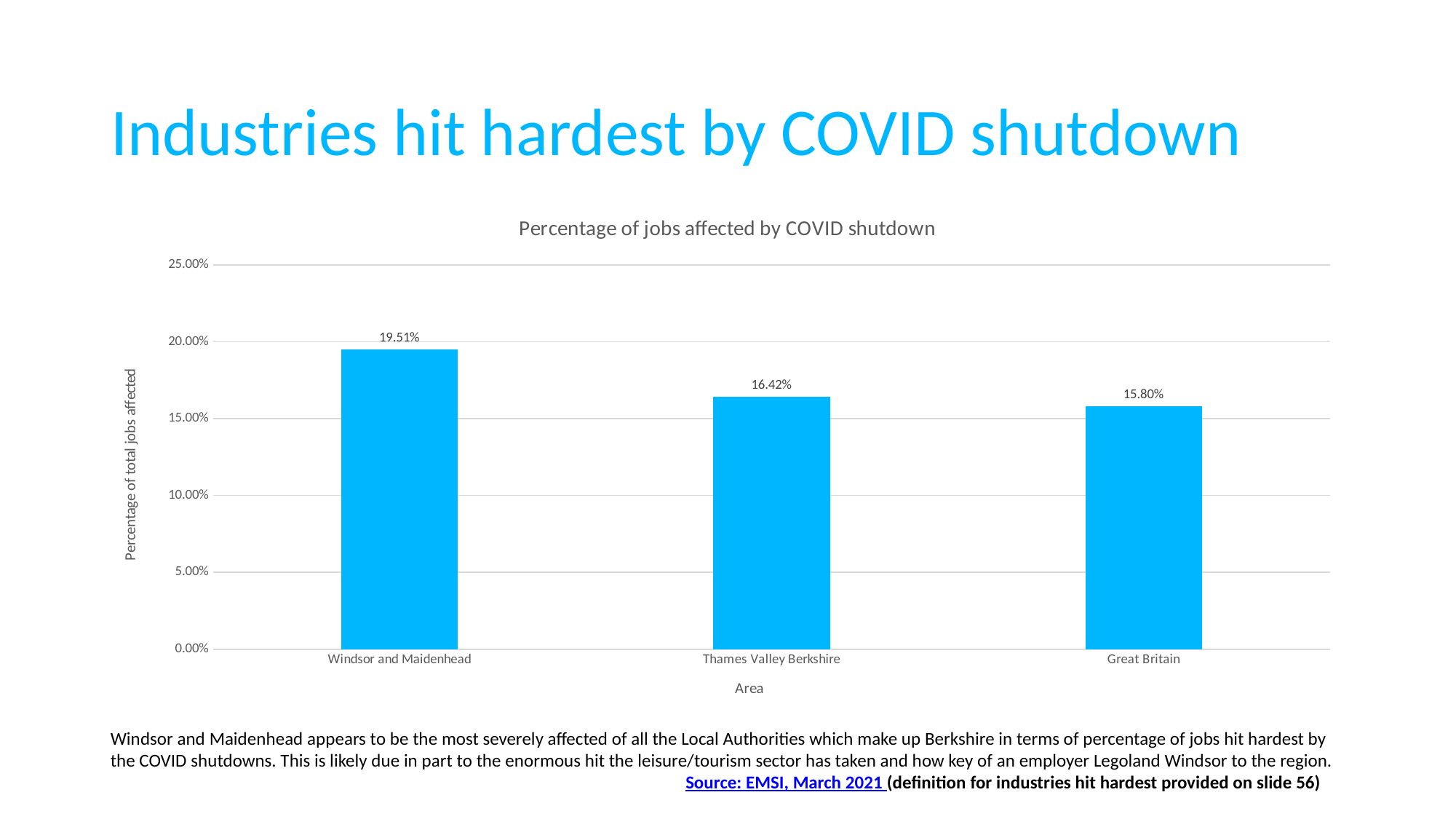
Which area has the highest percentage of jobs affected by COVID shutdown? Windsor and Maidenhead What is the difference in percentage points between Windsor and Maidenhead and Great Britain? 3.71% What kind of chart is shown on the slide? Bar chart Which has a higher percentage of jobs affected: Thames Valley Berkshire or Great Britain? Thames Valley Berkshire What is the percentage of jobs affected by COVID shutdown for Thames Valley Berkshire? 16.42% What is the percentage of jobs affected by COVID shutdown for Great Britain? 15.80% Is the value for Windsor and Maidenhead greater or less than 20.00%? less What is the percentage of jobs affected by COVID shutdown for Windsor and Maidenhead? 19.51% What is the title of the chart? Percentage of jobs affected by COVID shutdown How many areas are shown in the chart? 3 What is the difference in percentage points between Windsor and Maidenhead and Thames Valley Berkshire? 3.09% Which area has the lowest percentage of jobs affected by COVID shutdown? Great Britain